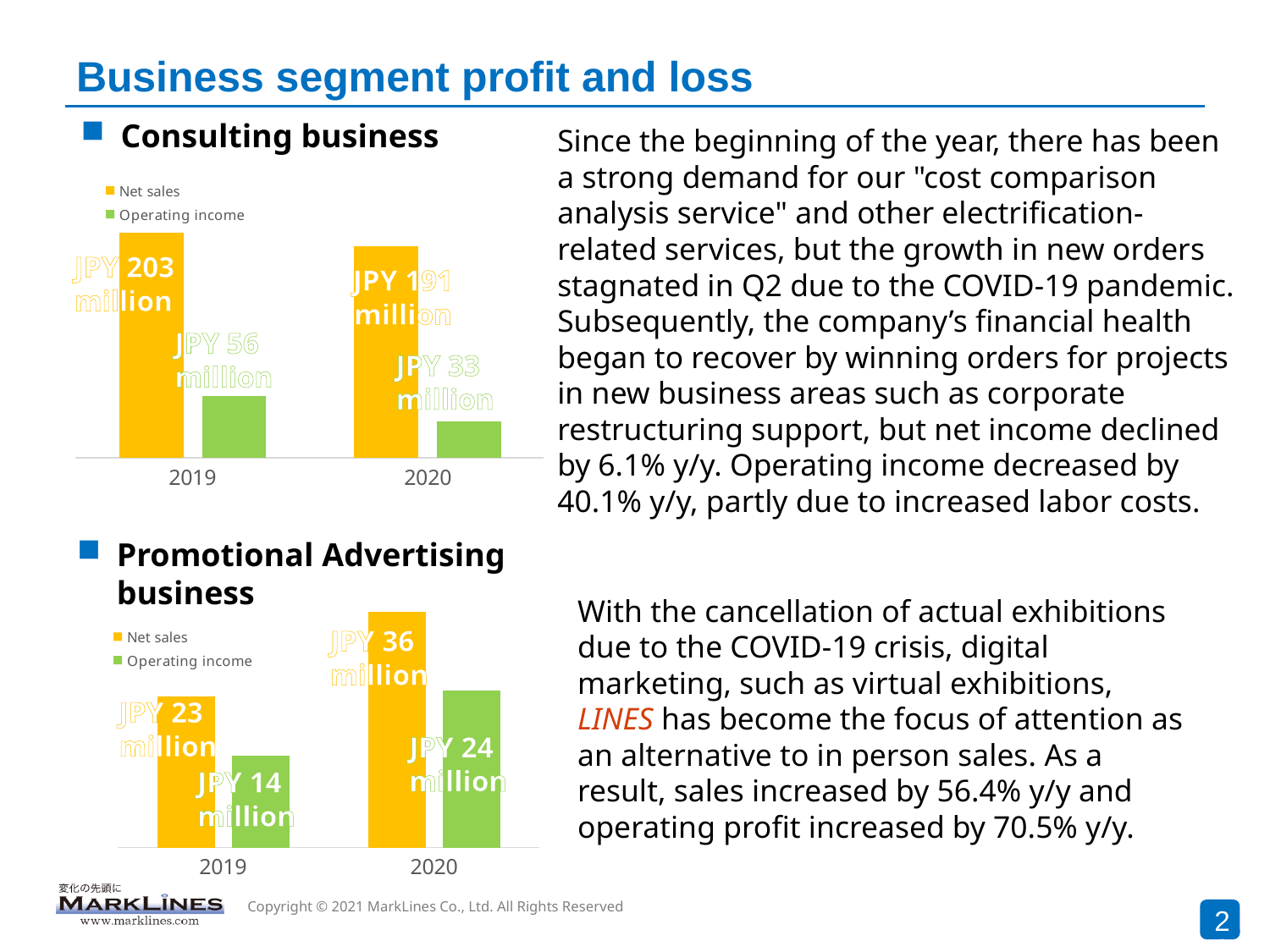
In the Consulting business chart, by how much did Net sales change from 2019 to 2020? JPY 12 million In the Promotional Advertising business chart, which year has the higher Net sales? 2020 In the Consulting business chart, which year has the higher Operating income? 2019 In the Consulting business chart, do Net sales rise or fall from 2019 to 2020? fall What type of chart is the Promotional Advertising business chart? bar chart In the Promotional Advertising business chart, what is the difference between Net sales and Operating income in 2020? JPY 12 million How many series does the legend of the Consulting business chart list? 2 In the Consulting business chart, what is the value of Net sales for 2019? JPY 203 million In the Consulting business chart, what is the value of Operating income for 2020? JPY 33 million In the Promotional Advertising business chart, what is the value of Net sales for 2020? JPY 36 million In the Promotional Advertising business chart, does Operating income rise or fall from 2019 to 2020? rise In the Promotional Advertising business chart, what is the value of Operating income for 2019? JPY 14 million